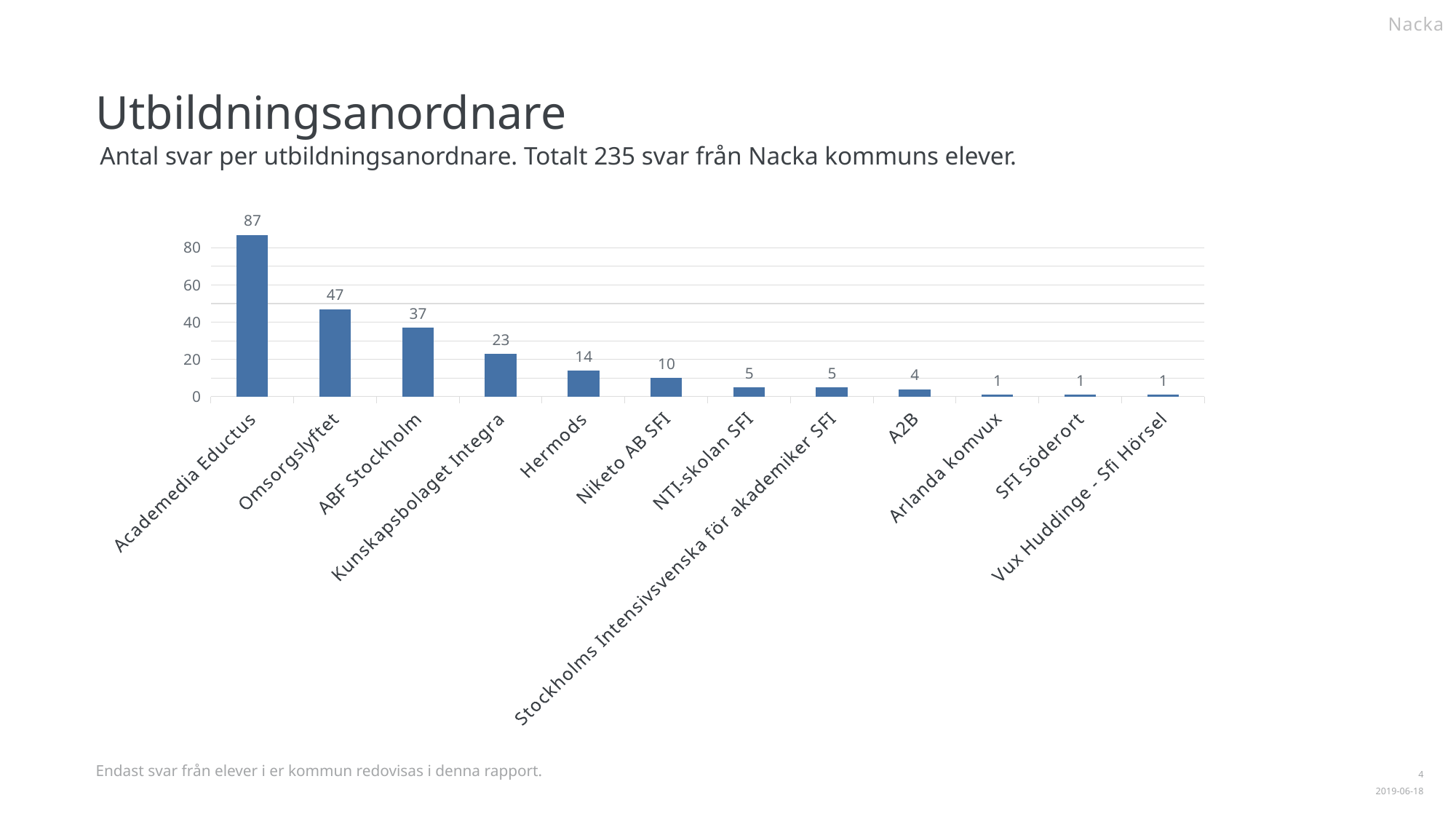
Which category has the highest value? Academedia Eductus What kind of chart is shown on the slide? bar chart What is the value for Academedia Eductus? 87 What is the value for Hermods? 14 What is the value for A2B? 4 Do the values rise or fall from left to right along the x axis? fall What is the value for Kunskapsbolaget Integra? 23 Which is larger, the value for Niketo AB SFI or the value for Hermods? Hermods What is the difference between the values for Omsorgslyftet and ABF Stockholm? 10 Is the value for ABF Stockholm greater or less than 40? less What is the difference between the values for Academedia Eductus and Omsorgslyftet? 40 How many categories are shown on the x axis? 12